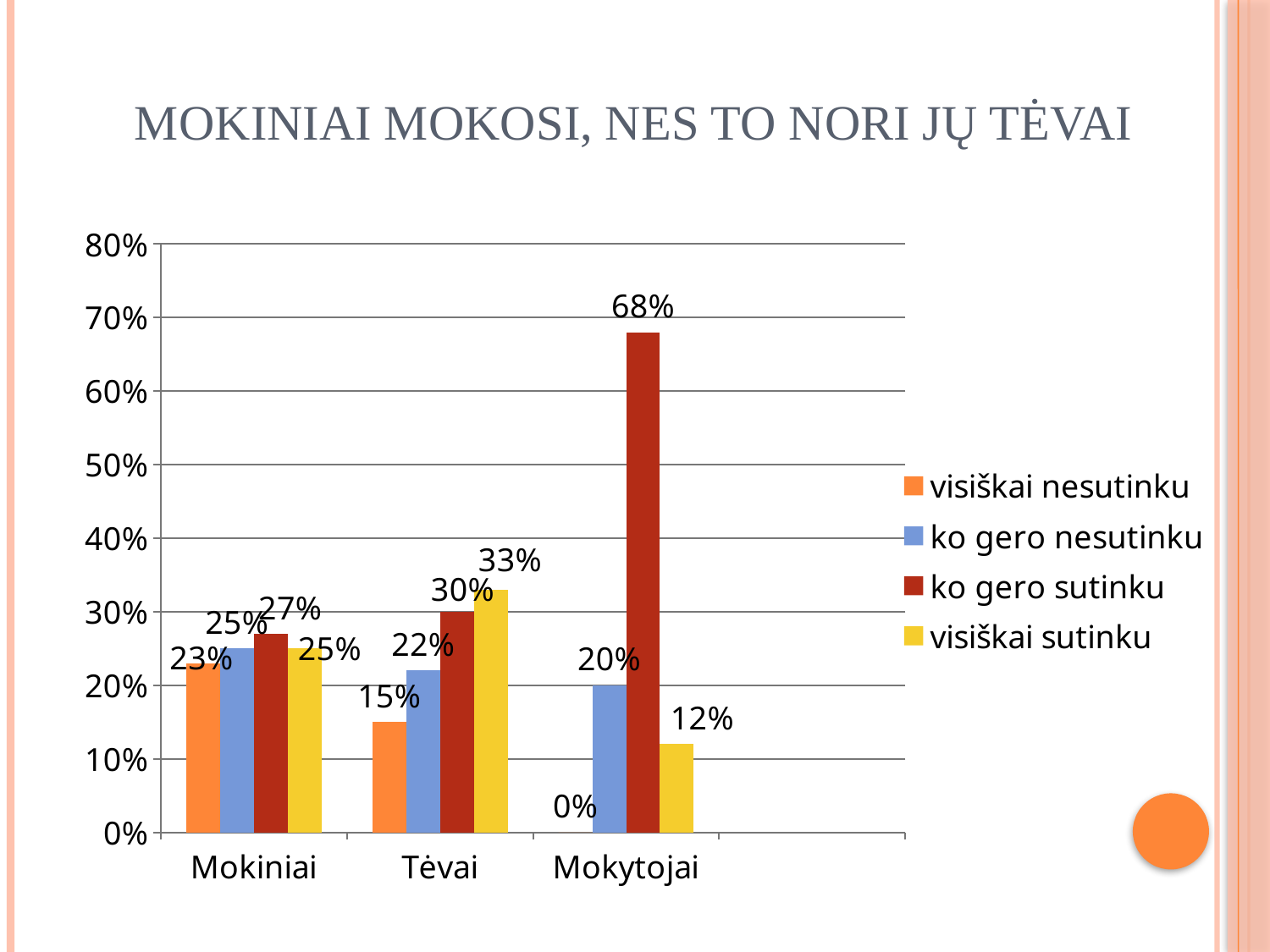
What is the value for "visiškai nesutinku" in the Mokytojai category? 0% Which is larger: the "visiškai sutinku" value for Tėvai or for Mokiniai? Tėvai How many series does the legend list? 4 What is the difference between the "ko gero sutinku" value for Mokytojai and for Tėvai? 38% Is the value for "ko gero sutinku" in the Mokytojai category greater or less than 60%? greater Which category has the lowest value for "visiškai sutinku"? Mokytojai What kind of chart is shown on the slide? bar chart What is the value for "ko gero sutinku" in the Mokytojai category? 68% What is the value for "visiškai nesutinku" in the Tėvai category? 15% What is the value for "visiškai sutinku" in the Mokiniai category? 25% Which category has the highest value for "ko gero sutinku"? Mokytojai How many categories are shown on the x axis? 3